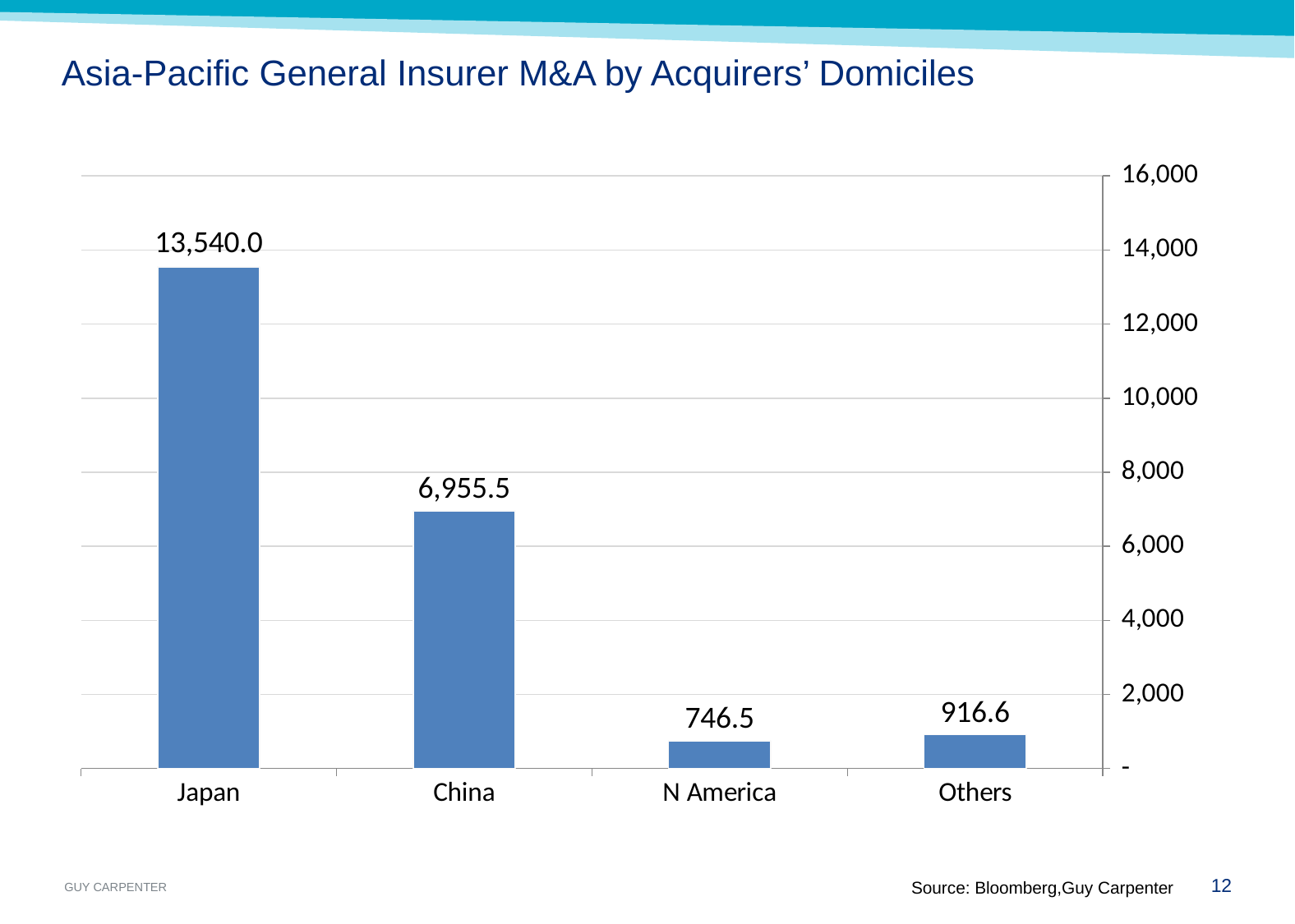
What is the value for Others? 916.6 What is the value for Japan? 13,540.0 What is the value for China? 6,955.5 Which is larger, the value for China or the value for Others? China Is the value for China greater or less than 8,000? less What is the difference between the values for Japan and China? 6,584.5 What is the difference between the values for Others and N America? 170.1 What kind of chart is shown on the slide? Bar chart How many categories are shown on the x axis? 4 What is the value for N America? 746.5 Which category has the lowest value? N America Which category has the highest value? Japan